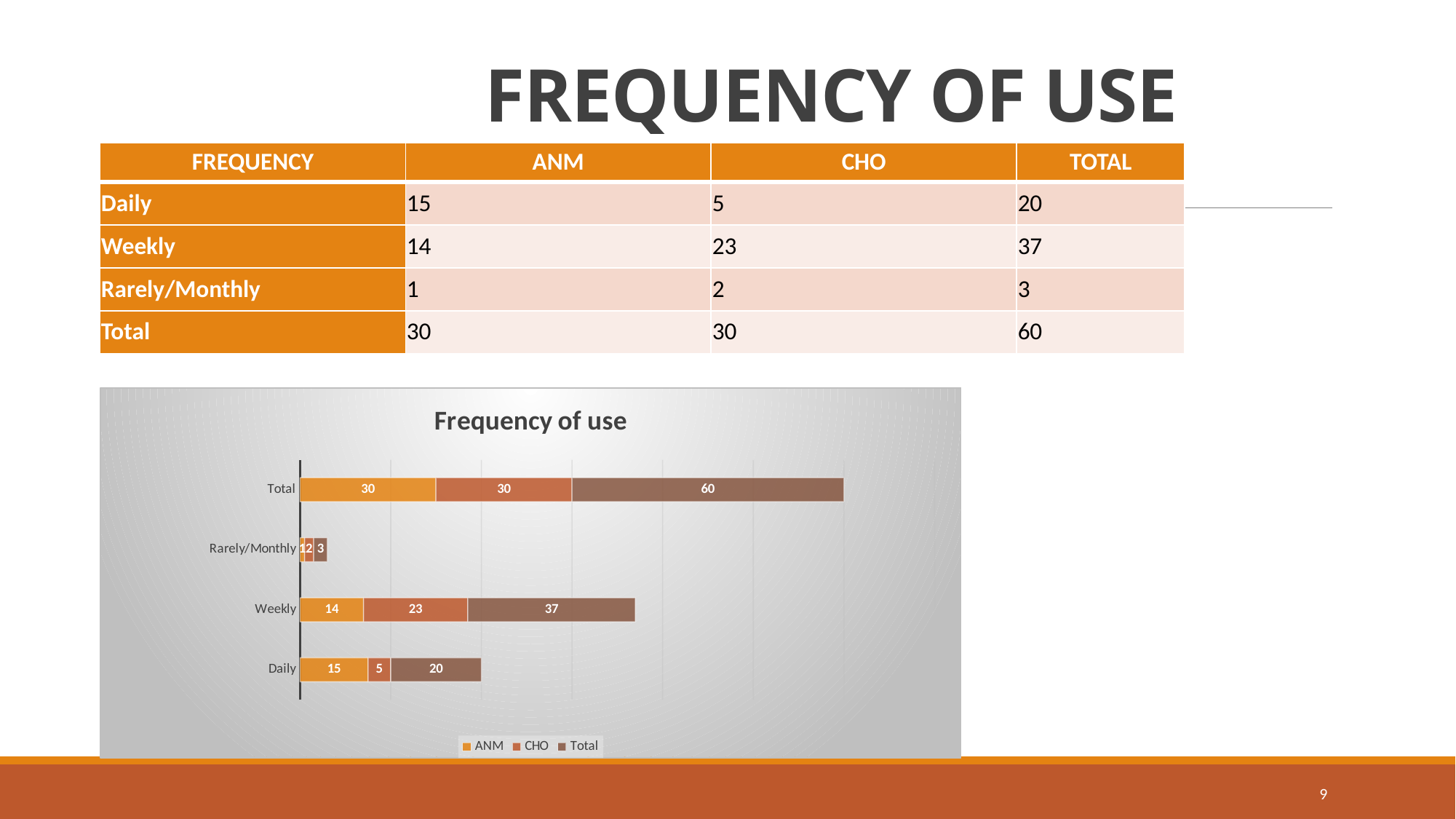
What is the CHO value for the Daily category? 5 What is the combined total of the stacked bar for the Weekly category? 74 Which category has the lowest ANM value? Rarely/Monthly How many series does the chart legend list? 3 What is the title of the chart? Frequency of use What is the difference between the CHO value and the ANM value for the Weekly category? 9 How many categories are shown on the chart's vertical axis? 4 What type of chart is shown on the slide? Stacked bar chart What is the ANM value for the Weekly category? 14 What is the Total series value for the Rarely/Monthly category? 3 Which category has the highest CHO value? Total Which is larger for the Daily category, the ANM value or the CHO value? ANM